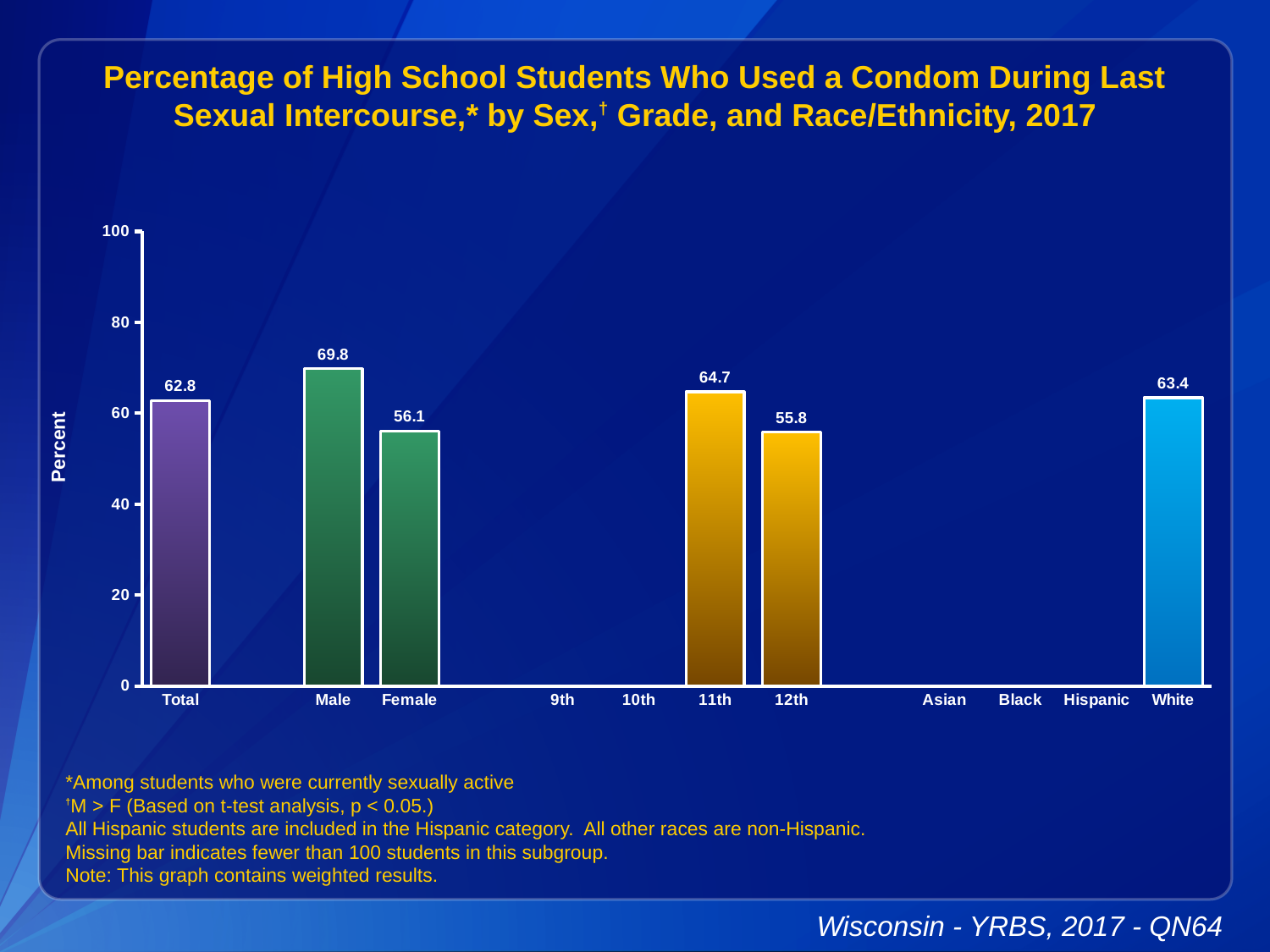
What is the value for Male? 69.8 How many categories have a bar plotted? 6 What is the value for Female? 56.1 Which is larger, the value for 11th grade or the value for 12th grade? 11th What kind of chart is this? bar chart Which category has the lowest value among the plotted bars? 12th What is the value for 11th grade? 64.7 What is the value for White? 63.4 What is the label on the y axis? Percent What is the difference between the Male and Female values? 13.7 Which category has the highest value? Male Is the value for Total greater or less than 60? greater